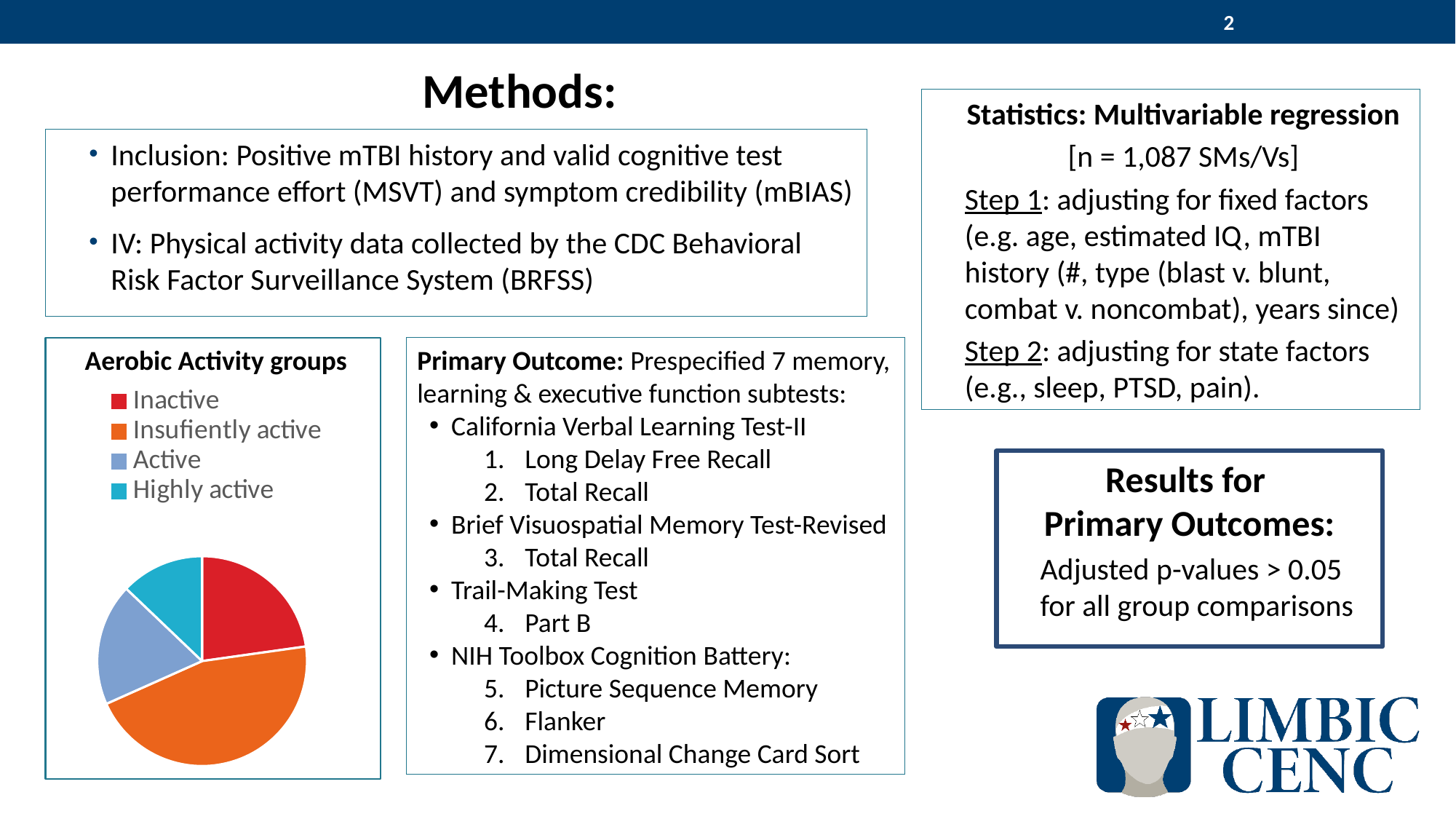
In the Aerobic Activity groups pie chart, which slice is larger: Insufiently active or Active? Insufiently active What colour is the Inactive slice in the Aerobic Activity groups pie chart? red How many categories does the Aerobic Activity groups pie chart have? 4 What kind of chart is shown under the heading "Aerobic Activity groups"? pie chart In the Aerobic Activity groups pie chart, which slice is larger: Inactive or Highly active? Inactive Which category in the Aerobic Activity groups pie chart is shown in orange? Insufiently active In the Aerobic Activity groups pie chart, which slice is larger: Active or Highly active? Active Which category has the smallest slice in the Aerobic Activity groups pie chart? Highly active Which category has the largest slice in the Aerobic Activity groups pie chart? Insufiently active